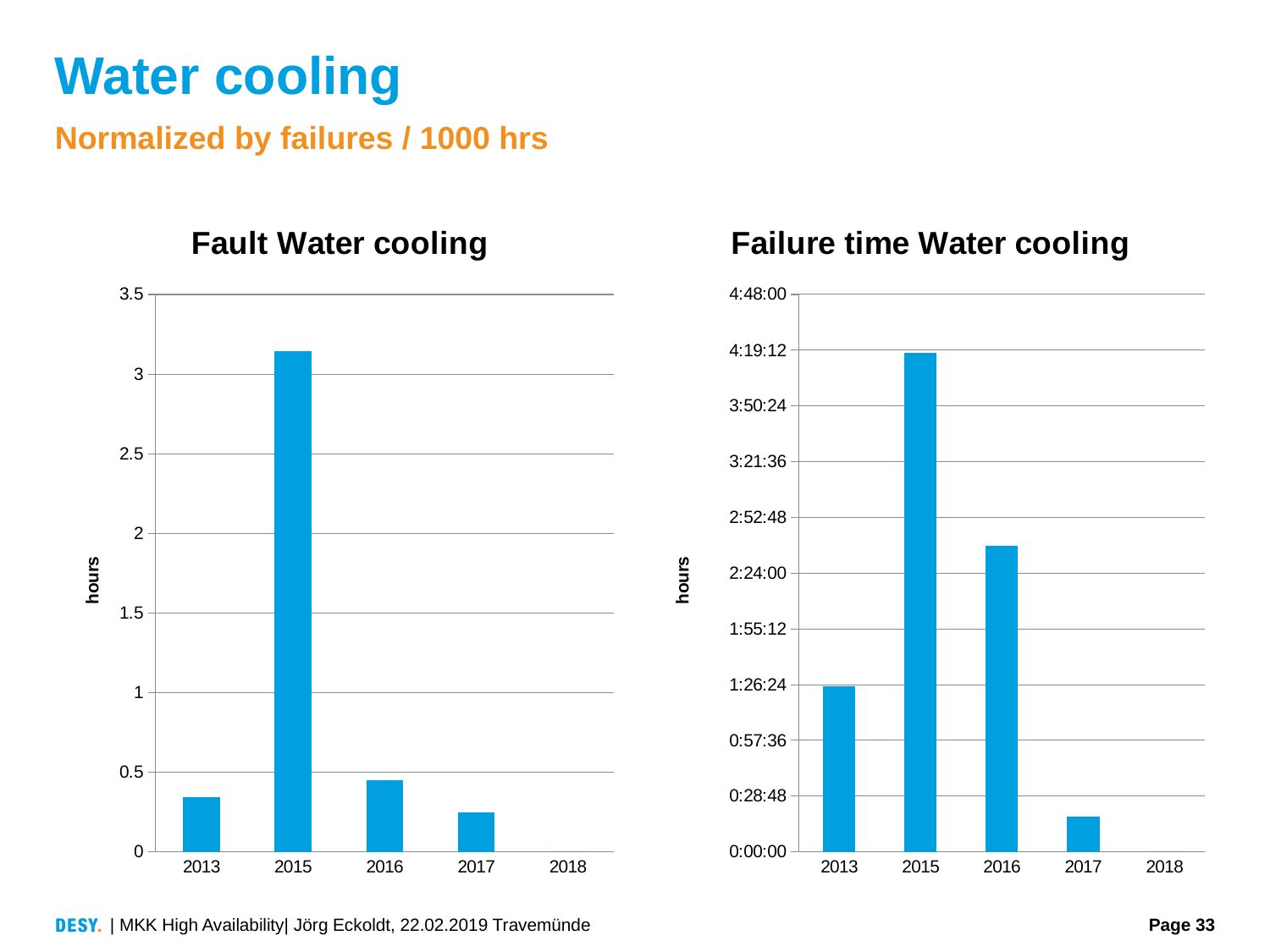
On the Failure time Water cooling chart, is the value for 2016 greater or less than 2:24:00? greater On the Fault Water cooling chart, is the value for 2015 greater or less than 3? greater On the Failure time Water cooling chart, is the value for 2017 greater or less than 0:28:48? less How many years are shown on the x axis of the Fault Water cooling chart? 5 On the Fault Water cooling chart, which year has the highest value? 2015 What is the y-axis label on the Fault Water cooling chart? hours On the Failure time Water cooling chart, which is larger, the value for 2013 or the value for 2016? 2016 On the Failure time Water cooling chart, which year has the lowest value? 2018 On the Failure time Water cooling chart, which year has the highest value? 2015 What kind of chart is the Failure time Water cooling chart? bar chart On the Fault Water cooling chart, which is larger, the value for 2016 or the value for 2017? 2016